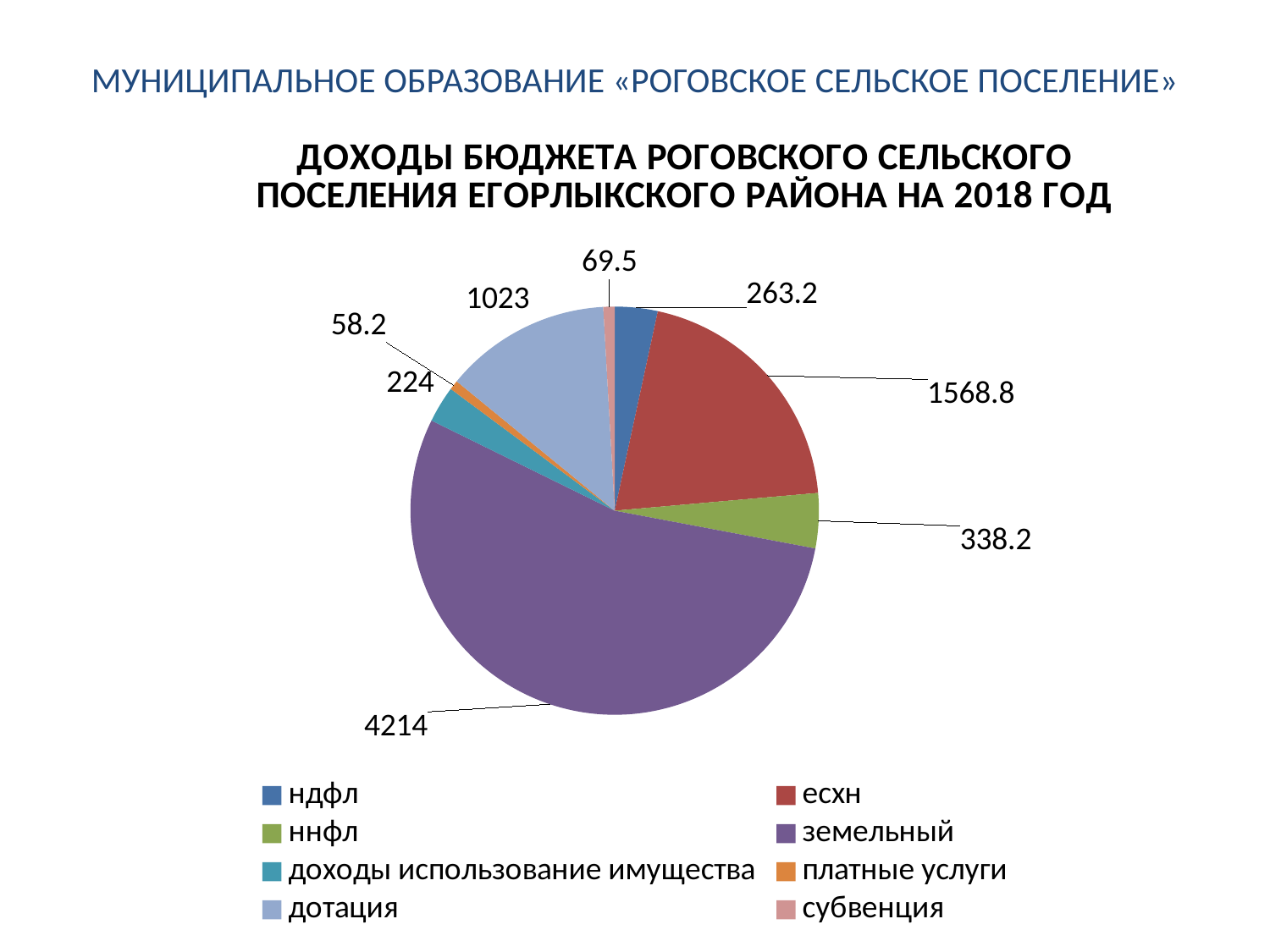
Which category has the smallest slice? платные услуги What is the value for есхн? 1568.8 What is the value for дотация? 1023 How many categories does the pie chart show? 8 What is the value for земельный? 4214 Which is larger, ннфл or ндфл? ннфл What is the difference between the values for есхн and дотация? 545.8 What is the value for субвенция? 69.5 What is the total of all the values shown in the pie chart? 7758.9 Which category has the largest slice? земельный What is the value for платные услуги? 58.2 What kind of chart is shown on the slide? pie chart